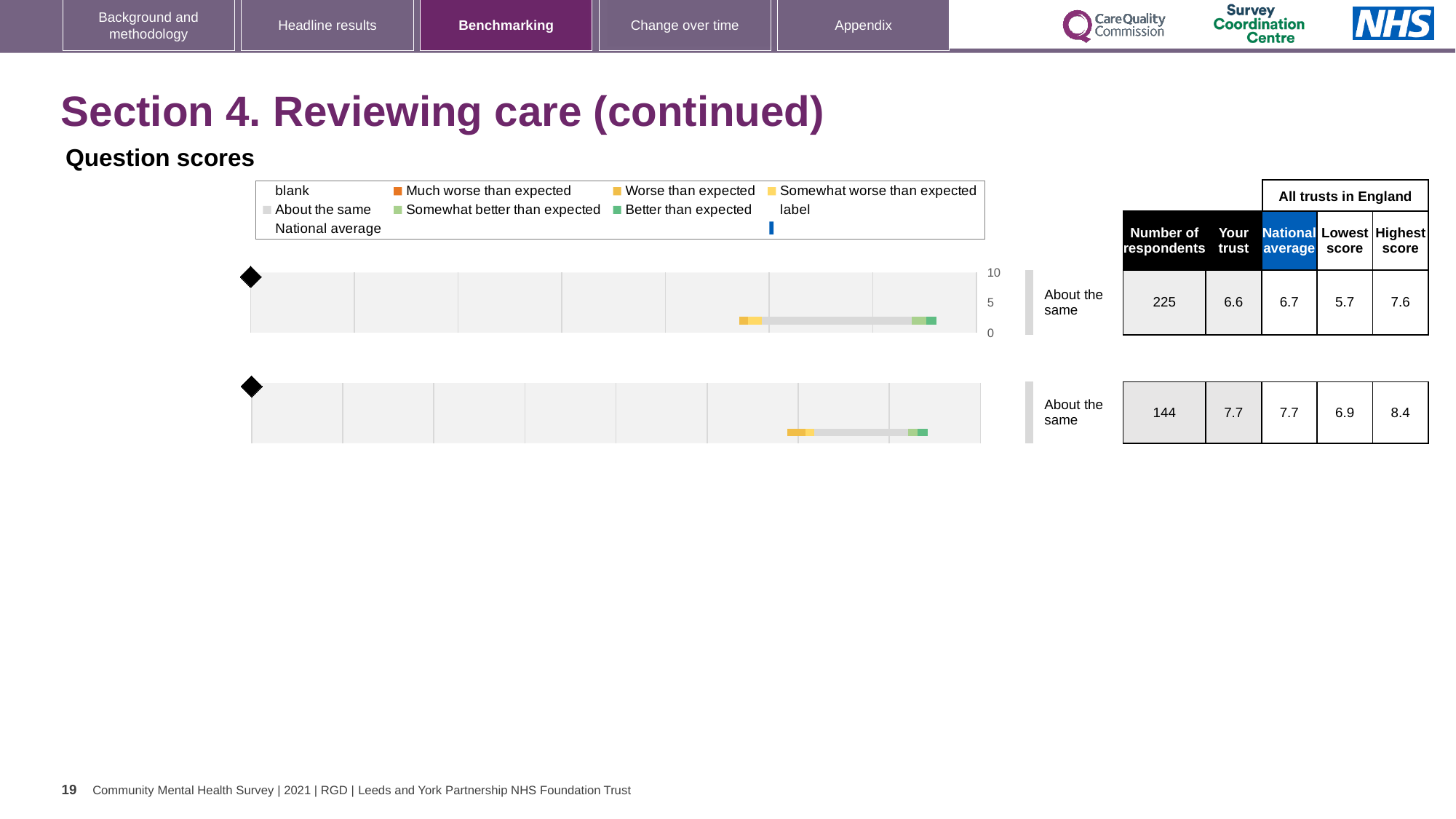
For the top chart, what is the 'Your trust' score shown in the table? 6.6 What kind of chart is used for the question scores on this slide? bar chart How many respondents are recorded for the top chart? 225 For the top chart, what is the national average score? 6.7 For the bottom chart, what is the 'Your trust' score shown in the table? 7.7 What benchmark category is given for the top chart? About the same Which chart has the higher 'Your trust' score, the top or the bottom? bottom What is the maximum value shown on the score axis of the top chart? 10 For the bottom chart, what is the highest score among all trusts in England? 8.4 What benchmark category is given for the bottom chart? About the same How many question score charts are shown on the slide? 2 What is the difference between the 'Your trust' scores of the bottom chart and the top chart? 1.1